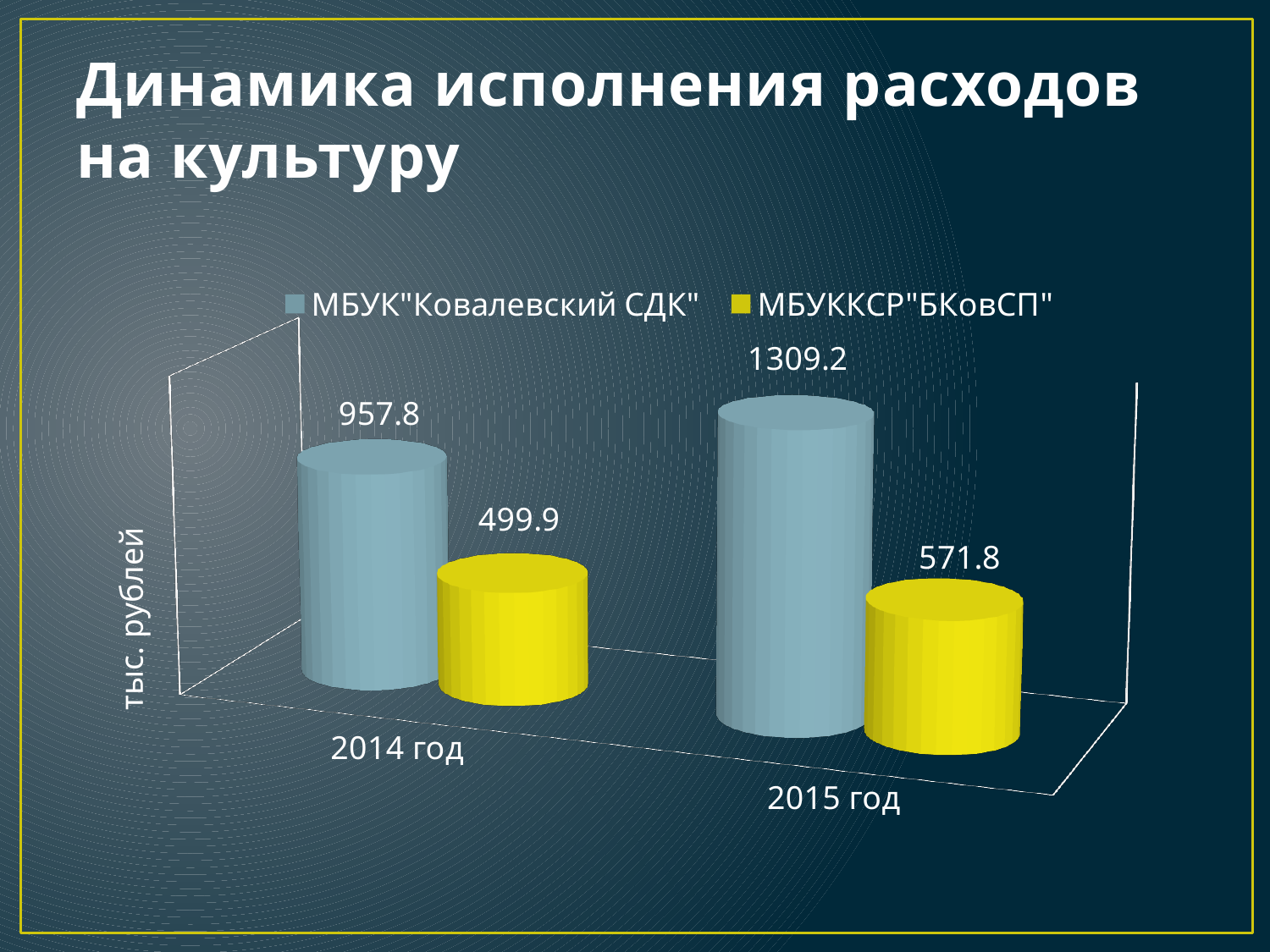
By how much did the value for МБУК"Ковалевский СДК" change from 2014 год to 2015 год? 351.4 What is the value for МБУККСР"БКовСП" in 2015 год? 571.8 Which series has the highest value on the chart? МБУК"Ковалевский СДК" What is the difference between the two series in 2015 год? 737.4 What is the value for МБУК"Ковалевский СДК" in 2014 год? 957.8 Which series has the larger value in 2014 год? МБУК"Ковалевский СДК" What is the value for МБУККСР"БКовСП" in 2014 год? 499.9 Do the values for МБУККСР"БКовСП" rise or fall from 2014 год to 2015 год? Rise What is the value for МБУК"Ковалевский СДК" in 2015 год? 1309.2 How many series does the legend list? 2 What kind of chart is shown on the slide? Bar chart Which bar has the lowest value on the chart? МБУККСР"БКовСП" in 2014 год